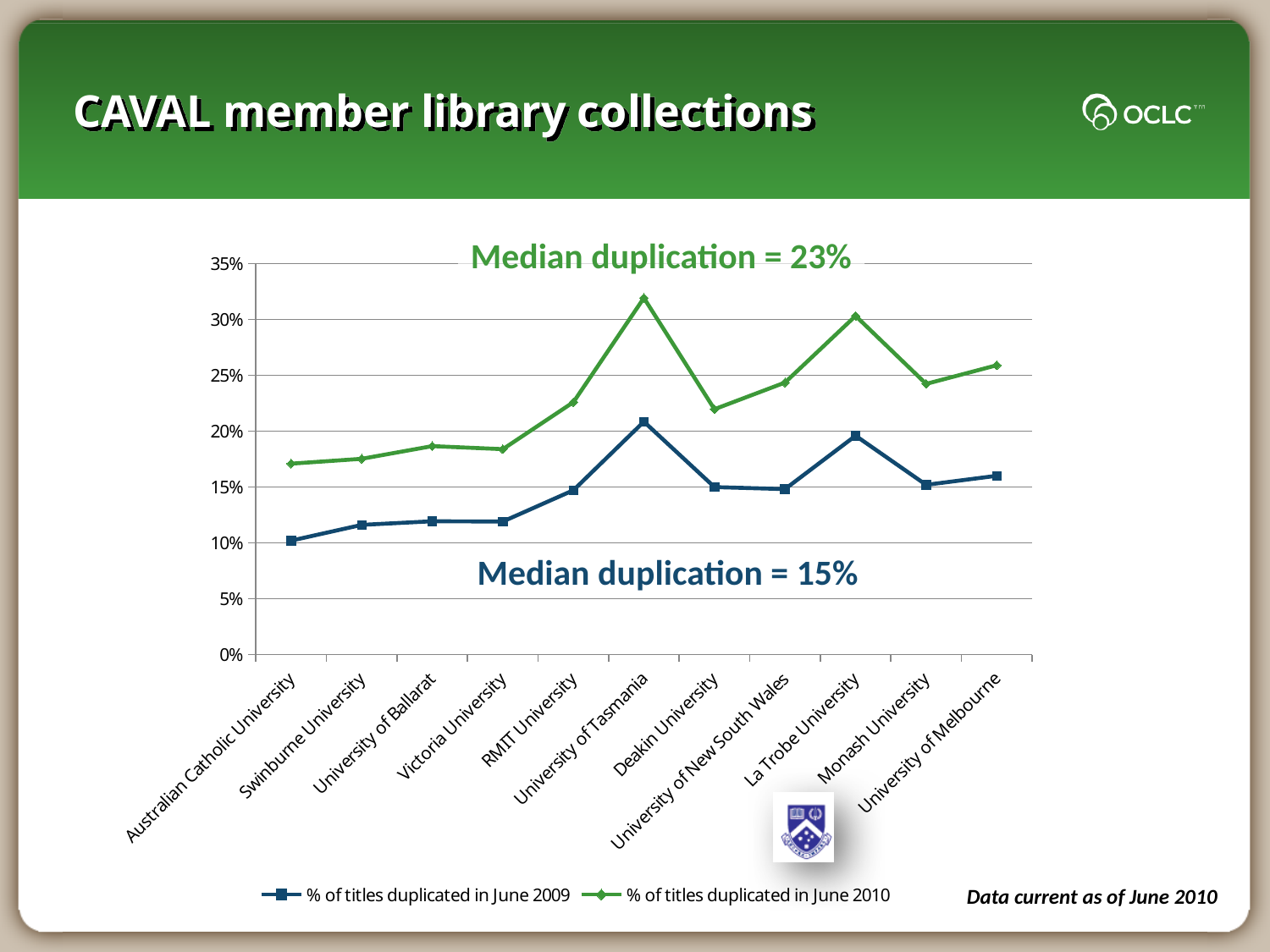
Is the % of titles duplicated in June 2009 for University of Ballarat greater or less than 10%? greater Is the % of titles duplicated in June 2010 for Deakin University greater or less than 25%? less Is the % of titles duplicated in June 2010 for University of Tasmania greater or less than 30%? greater For June 2010, which is larger: the value for University of Tasmania or the value for Deakin University? University of Tasmania What median duplication is stated for the June 2010 series? 23% How many universities are plotted along the x axis? 11 Which university has the highest % of titles duplicated in June 2010? University of Tasmania How many series does the legend list? 2 Do the June 2009 values rise or fall from Australian Catholic University to University of Tasmania? rise What kind of chart is shown on the slide? line chart Which university has the lowest % of titles duplicated in June 2009? Australian Catholic University Which university has the lowest % of titles duplicated in June 2010? Australian Catholic University